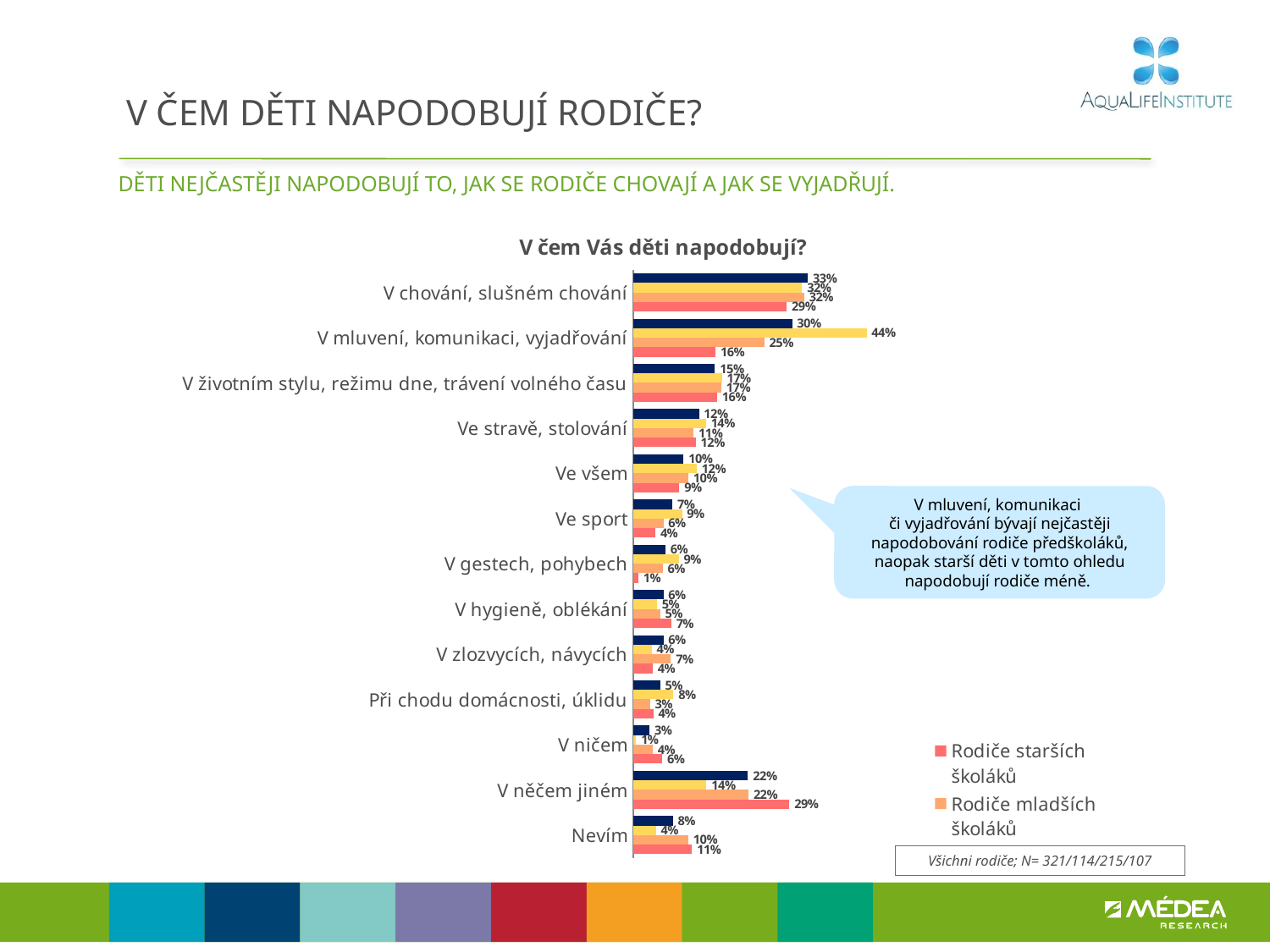
What kind of chart is shown on the slide? bar chart What is the highest value shown anywhere on the chart? 44% For Rodiče starších školáků, which is larger: 'V něčem jiném' or 'Nevím'? V něčem jiném What is the value for Rodiče starších školáků in 'V gestech, pohybech'? 1% What is the difference between Rodiče mladších školáků and Rodiče starších školáků in 'V mluvení, komunikaci, vyjadřování'? 9 percentage points How many categories are listed on the chart? 13 What is the chart's title? V čem Vás děti napodobují? What is the value for Rodiče mladších školáků in the category 'V mluvení, komunikaci, vyjadřování'? 25% What is the value for Rodiče mladších školáků in 'Nevím'? 10% What is the value for Rodiče starších školáků in the category 'V mluvení, komunikaci, vyjadřování'? 16% In which category does Rodiče starších školáků have its lowest value? V gestech, pohybech What sample note is shown in the box at the bottom right of the chart? Všichni rodiče; N= 321/114/215/107